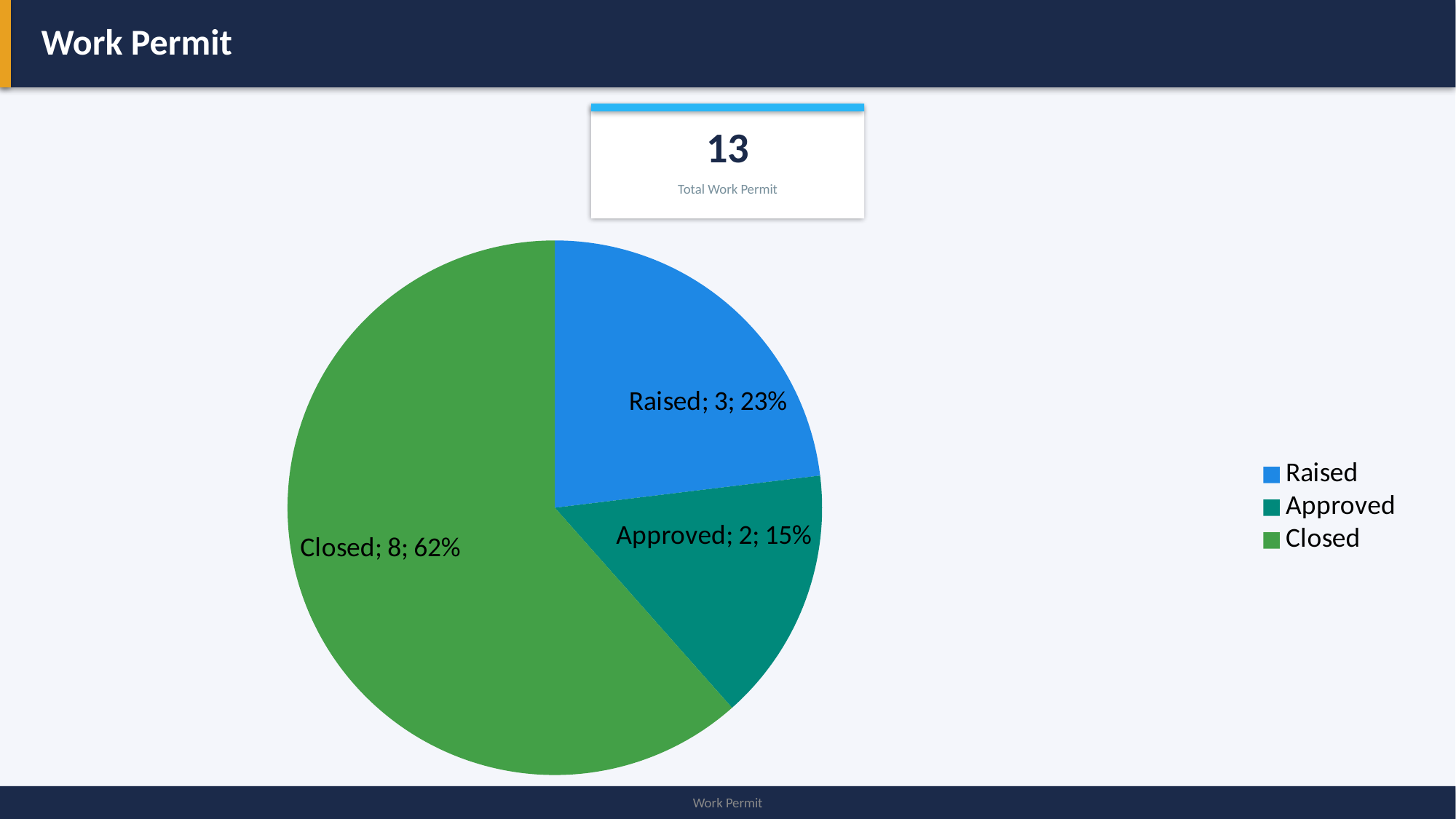
Which category has the largest slice of the pie? Closed How many work permits are Raised? 3 Which category has the smallest slice of the pie? Approved How many work permits are Closed? 8 Which is larger, the Raised slice or the Approved slice? Raised How many work permits are Approved? 2 What share of the pie does the Approved slice represent? 15% What share of the pie does the Closed slice represent? 62% What is the difference between the number of Closed and Raised work permits? 5 How many categories does the legend list? 3 What kind of chart is shown on the slide? pie chart What share of the pie does the Raised slice represent? 23%